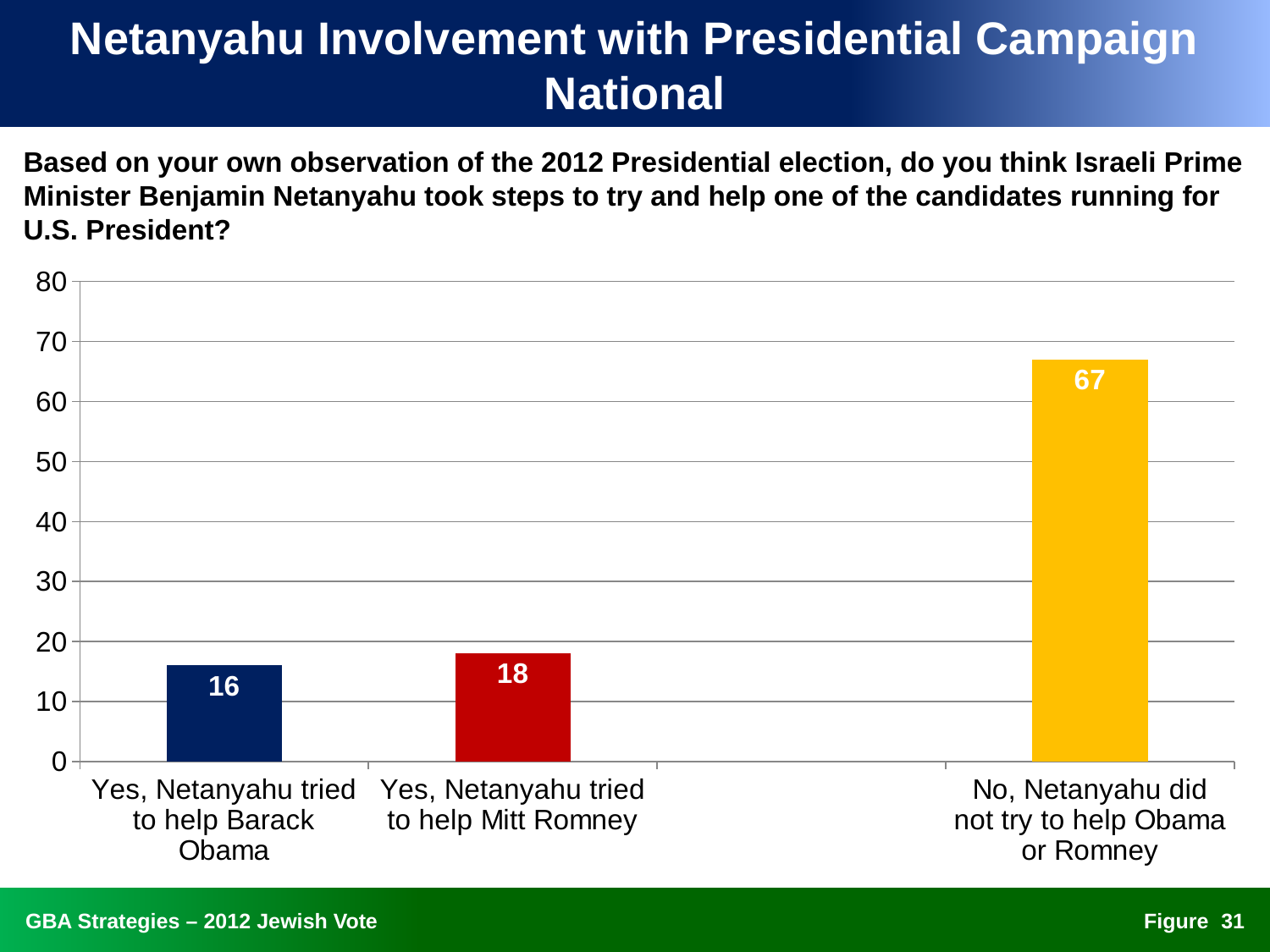
How many categories are shown on the chart? 3 What is the value for "Yes, Netanyahu tried to help Barack Obama"? 16 What is the title of the slide? Netanyahu Involvement with Presidential Campaign National Which category has the highest value? No, Netanyahu did not try to help Obama or Romney Which category has the lowest value? Yes, Netanyahu tried to help Barack Obama Which is larger: the value for "Yes, Netanyahu tried to help Barack Obama" or the value for "No, Netanyahu did not try to help Obama or Romney"? No, Netanyahu did not try to help Obama or Romney What is the value for "Yes, Netanyahu tried to help Mitt Romney"? 18 What kind of chart is shown on the slide? bar chart What is the value for "No, Netanyahu did not try to help Obama or Romney"? 67 Is the value for "No, Netanyahu did not try to help Obama or Romney" greater or less than 60? greater What is the difference between the value for "No, Netanyahu did not try to help Obama or Romney" and the value for "Yes, Netanyahu tried to help Mitt Romney"? 49 What is the difference between the value for "Yes, Netanyahu tried to help Mitt Romney" and the value for "Yes, Netanyahu tried to help Barack Obama"? 2